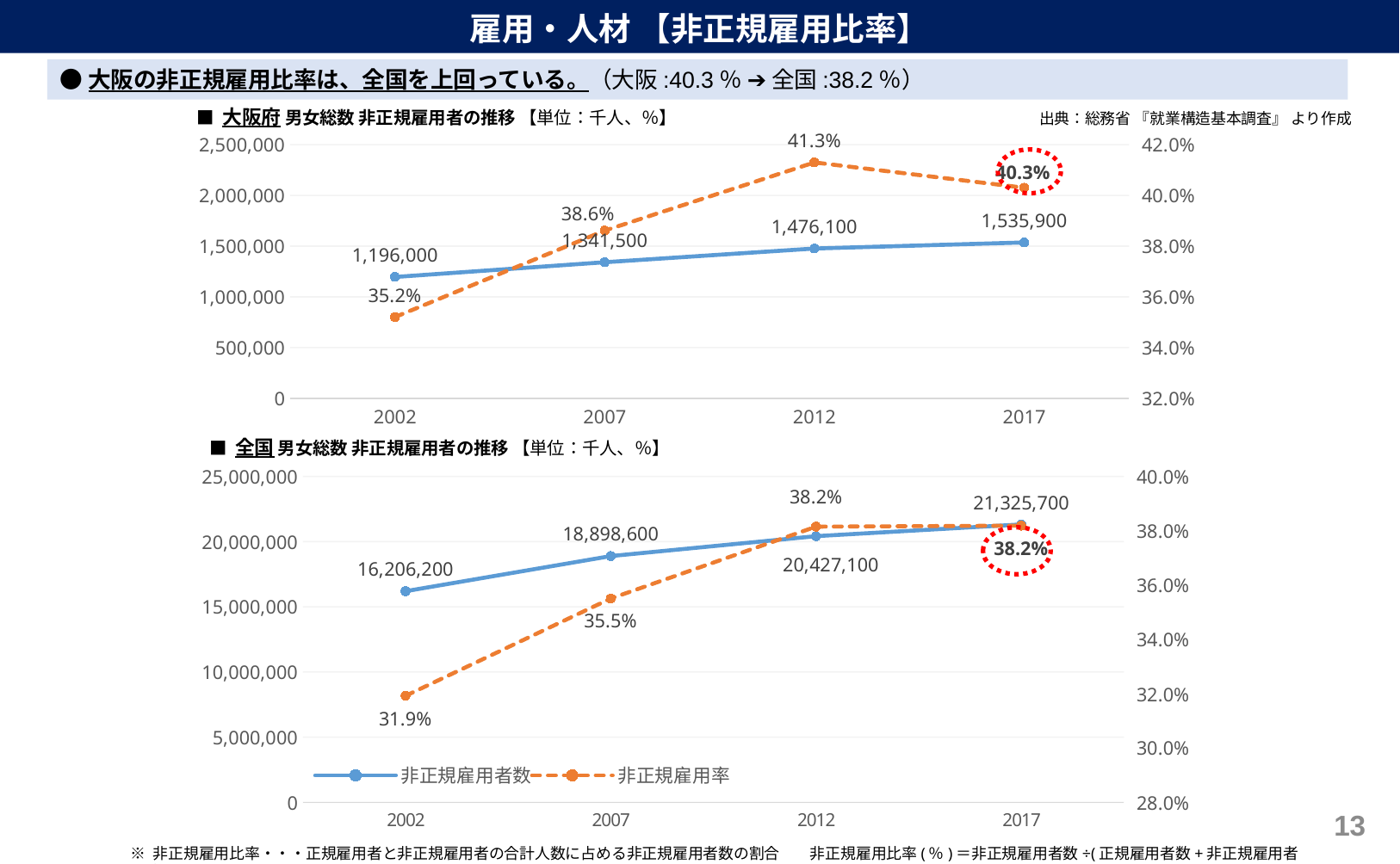
What kind of chart is the 大阪府 chart (top)? line chart In the 大阪府 chart (top), which year has the highest 非正規雇用率? 2012 In the 全国 chart (bottom), what is the value of 非正規雇用者数 in 2002? 16,206,200 In the 大阪府 chart (top), what is the value of 非正規雇用者数 in 2017? 1,535,900 How many series does the legend on the 全国 chart (bottom) list? 2 In the 大阪府 chart (top), what is the 非正規雇用率 in 2012? 41.3% In the 全国 chart (bottom), which year has the lowest 非正規雇用率? 2002 In the 全国 chart (bottom), is the 非正規雇用者数 in 2007 greater or less than 20,000,000? less In the 大阪府 chart (top), what is the difference in 非正規雇用者数 between 2017 and 2002? 339,900 In the 大阪府 chart (top), does the 非正規雇用者数 rise or fall from 2002 to 2017? rise In the 全国 chart (bottom), what is the 非正規雇用率 in 2007? 35.5% In the 全国 chart (bottom), what is the difference in 非正規雇用者数 between 2017 and 2012? 898,600